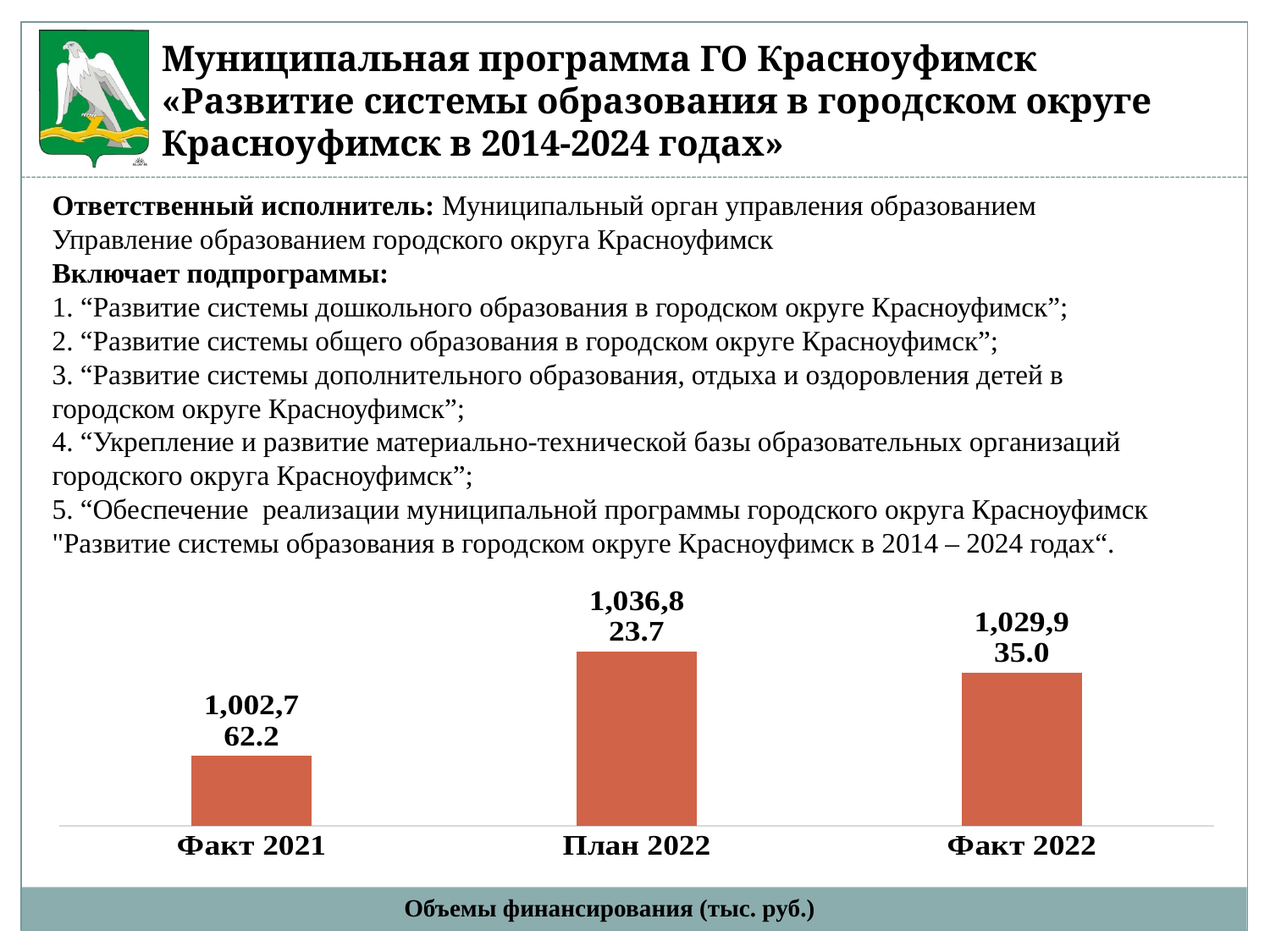
What type of chart is shown on the slide? bar chart What is the title of the chart? Объемы финансирования (тыс. руб.) Which is larger, the value for Факт 2021 or the value for Факт 2022? Факт 2022 Which category has the highest value? План 2022 What is the value for План 2022? 1,036,823.7 What is the difference between the values for План 2022 and Факт 2022? 6,888.7 How many bars (categories) does the chart show? 3 Which category has the lowest value? Факт 2021 Which is larger, the value for План 2022 or the value for Факт 2022? План 2022 What is the difference between the values for Факт 2022 and Факт 2021? 27,172.8 What is the value for Факт 2021? 1,002,762.2 What is the value for Факт 2022? 1,029,935.0